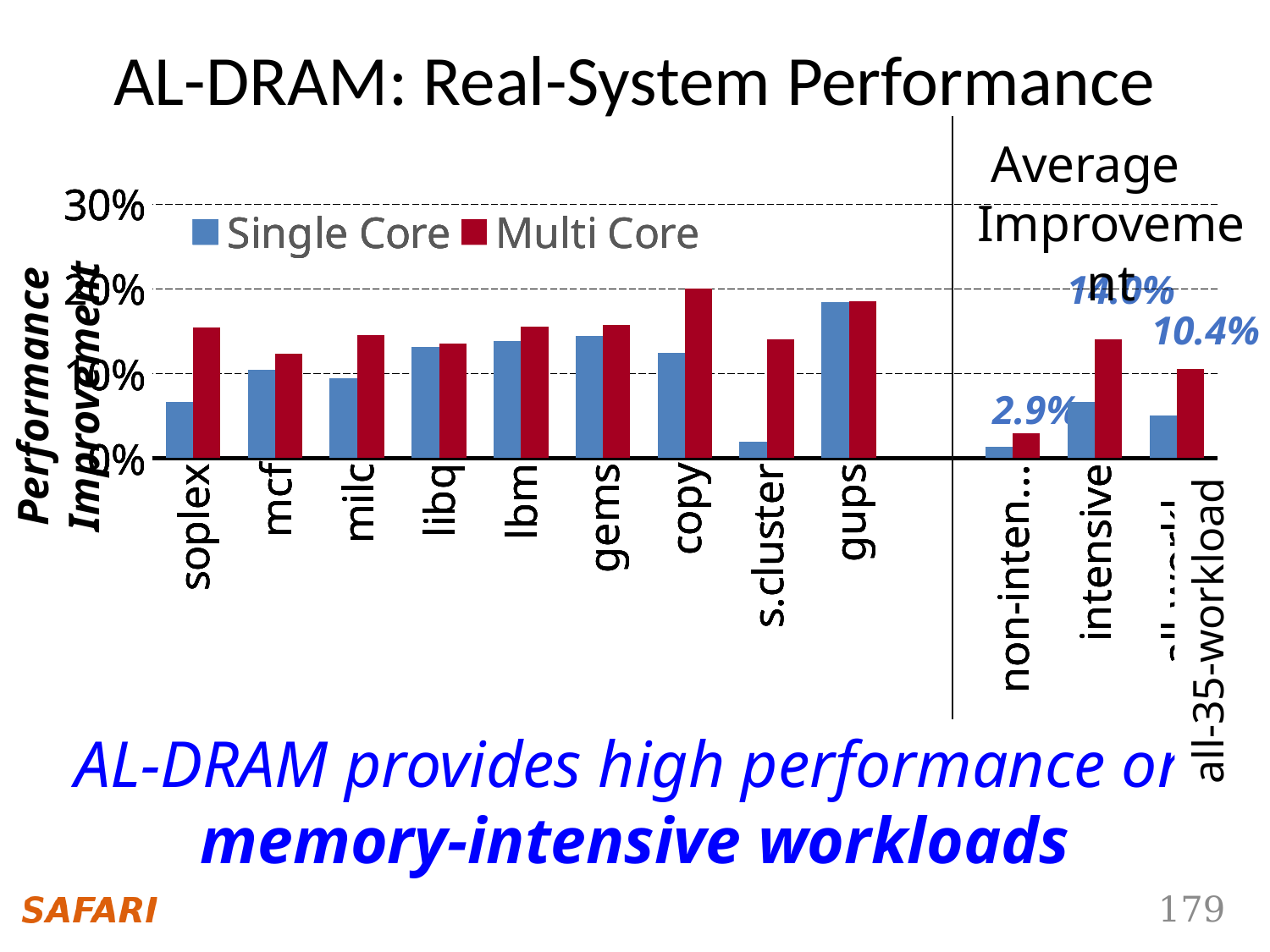
Among the nine individual benchmarks (soplex through gups), which has the highest Multi Core improvement? copy What is the Multi Core performance improvement for all-workload? 10.4% Is the Multi Core value for copy greater or less than 10%? greater For soplex, which is larger: the Single Core or the Multi Core improvement? Multi Core What kind of chart is shown on the slide? bar chart Among the nine individual benchmarks (soplex through gups), which has the highest Single Core improvement? gups How many series does the legend list? 2 What is the difference between the Multi Core improvement for all-workload (10.4%) and for non-intensive (2.9%)? 7.5% How many individual benchmarks are plotted to the left of the vertical divider line? 9 What are the two series named in the legend? Single Core and Multi Core What is the Multi Core performance improvement for the non-intensive workloads? 2.9% Among the nine individual benchmarks (soplex through gups), which has the lowest Single Core improvement? s.cluster